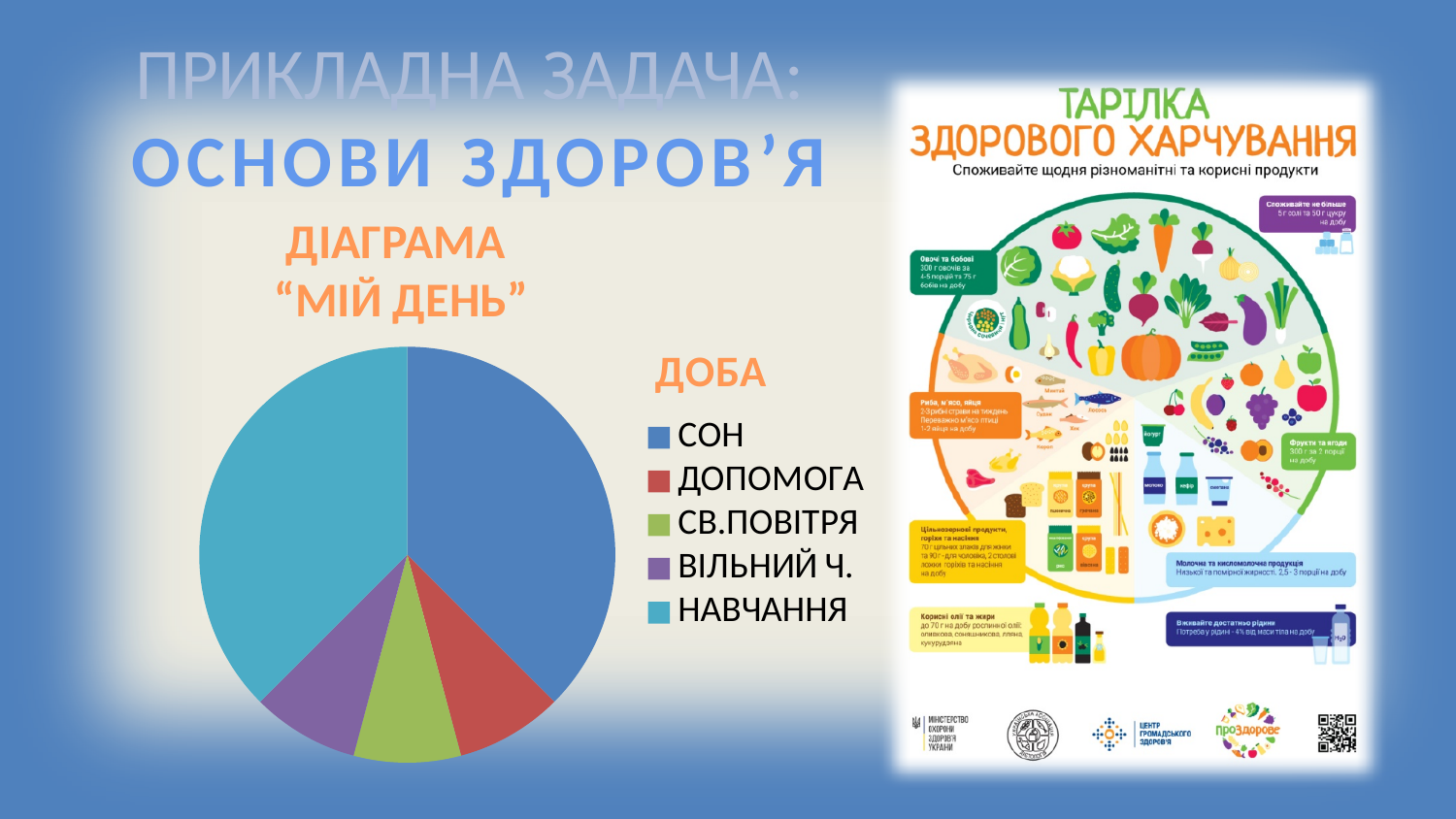
What is the heading shown above the legend of the pie chart "МІЙ ДЕНЬ"? ДОБА How many entries does the legend of the pie chart "МІЙ ДЕНЬ" list? 5 In the pie chart "МІЙ ДЕНЬ", which slice is larger: НАВЧАННЯ or ВІЛЬНИЙ Ч.? НАВЧАННЯ In the pie chart "МІЙ ДЕНЬ", which slice is larger: СОН or ВІЛЬНИЙ Ч.? СОН How many categories does the pie chart "МІЙ ДЕНЬ" show? 5 Which legend entry of the pie chart "МІЙ ДЕНЬ" is shown in red? ДОПОМОГА What kind of chart is shown on the slide under the heading "ДІАГРАМА "МІЙ ДЕНЬ""? Pie chart In the pie chart "МІЙ ДЕНЬ", which slice is larger: СОН or ДОПОМОГА? СОН